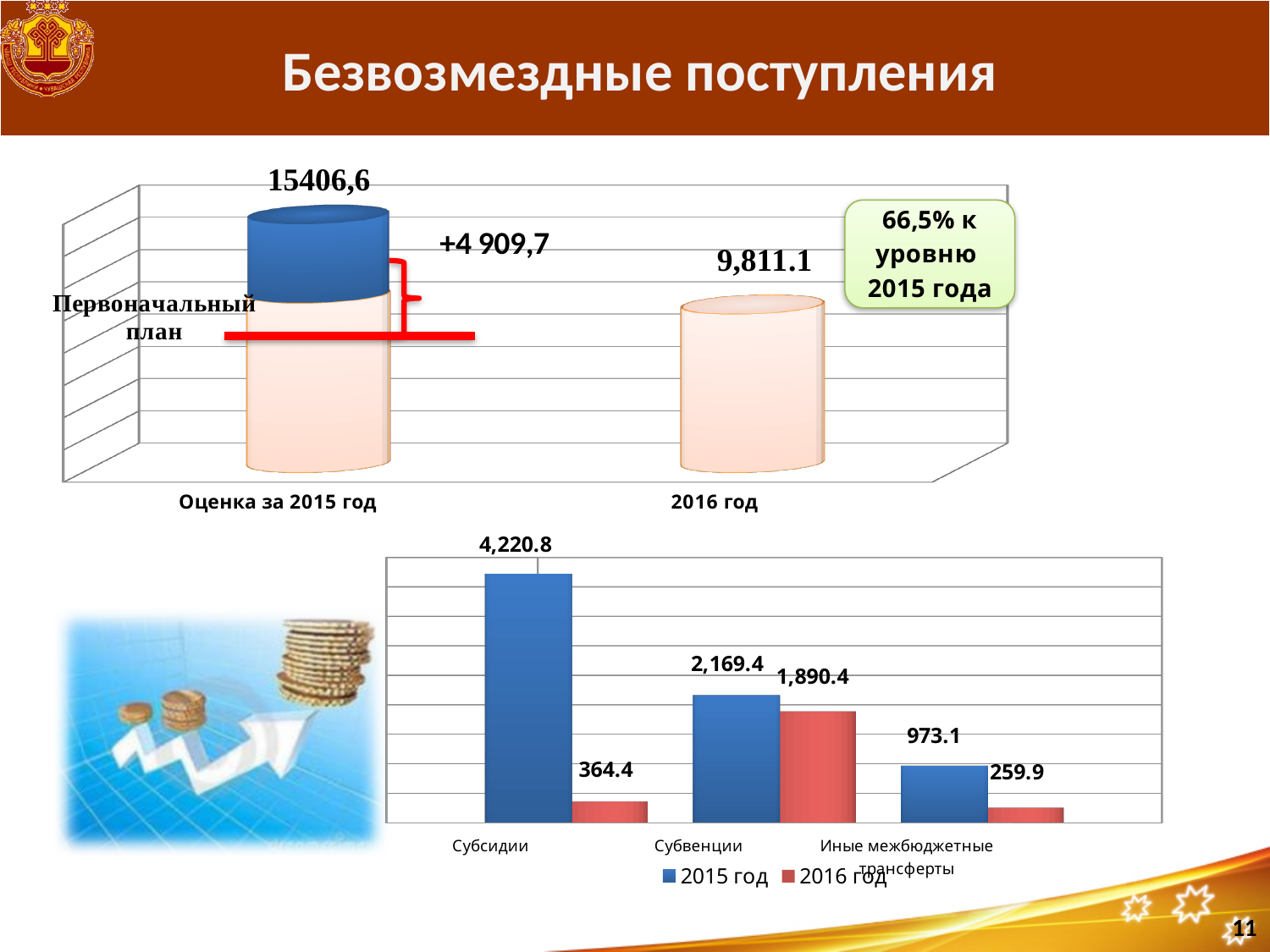
In the bottom chart, what is the value for 'Субвенции' in the '2016 год' series? 1,890.4 In the top chart, what percentage relative to the 2015 level is shown in the callout? 66,5% In the bottom chart, which category has the lowest value in the '2016 год' series? Иные межбюджетные трансферты In the top chart, what is the value for '2016 год'? 9,811.1 In the top chart, which category has the higher value, 'Оценка за 2015 год' or '2016 год'? Оценка за 2015 год In the bottom chart, what is the difference between the '2015 год' and '2016 год' values for 'Субсидии'? 3,856.4 In the bottom chart, what is the value for 'Иные межбюджетные трансферты' in the '2015 год' series? 973.1 In the top chart, what is the value for 'Оценка за 2015 год'? 15406,6 In the bottom chart, how many series does the legend list? 2 What kind of chart is the bottom chart? Bar chart In the bottom chart, which category has the highest value in the '2015 год' series? Субсидии In the bottom chart, what is the value for 'Субсидии' in the '2015 год' series? 4,220.8